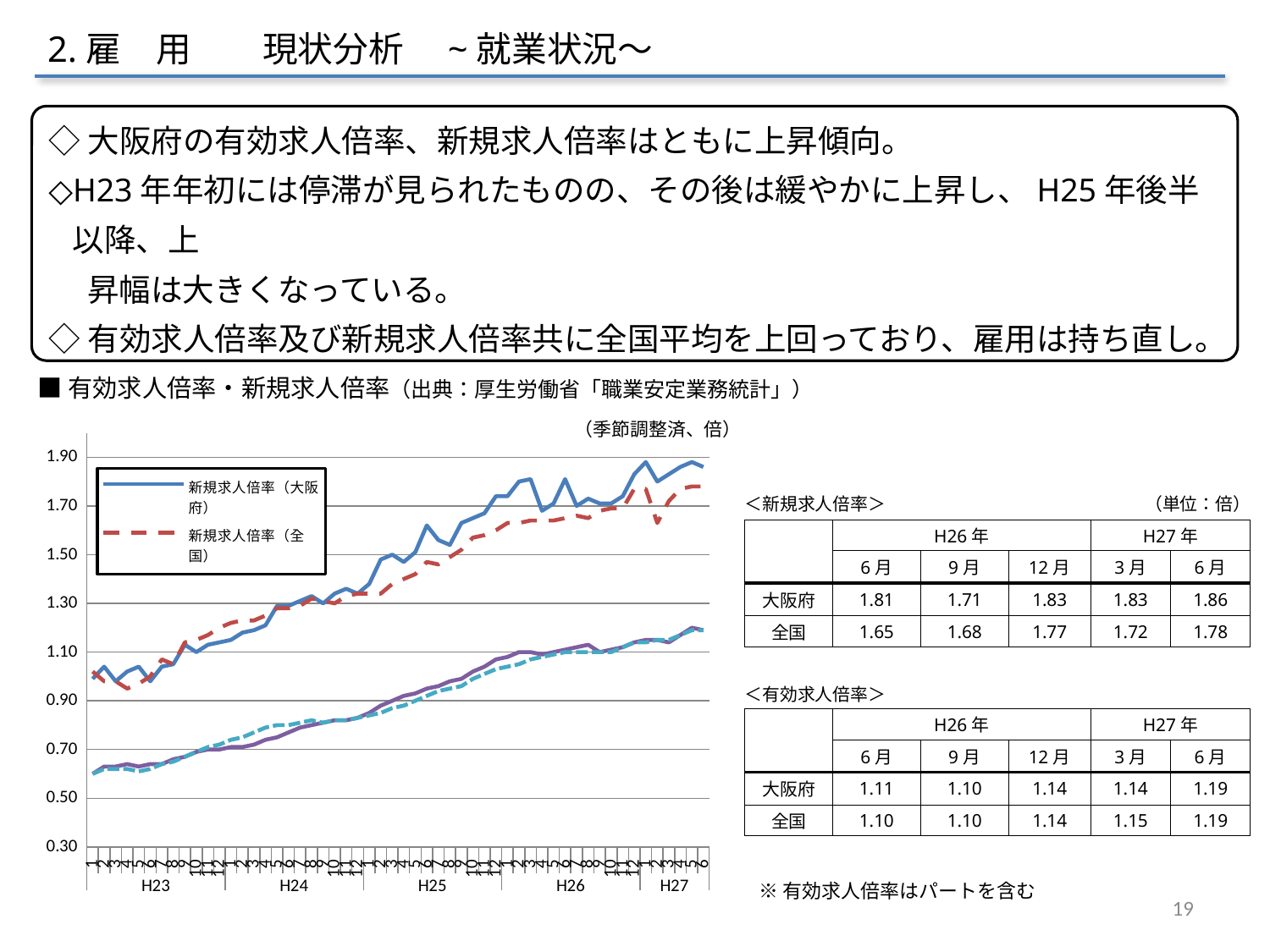
In the 新規求人倍率 table, which is larger in H26年9月, 大阪府 or 全国? 大阪府 Is the value of the 新規求人倍率（大阪府） line at the end of H27 greater or less than 1.70? greater According to the 有効求人倍率 table, what is the value for 大阪府 in H27年6月? 1.19 Is the value of the 新規求人倍率（全国） line at the start of H23 greater or less than 1.10? less What kind of chart is shown on the slide? line chart In the 新規求人倍率 table, what is the difference between 大阪府 and 全国 in H27年6月? 0.08 According to the 新規求人倍率 table, what is the value for 大阪府 in H27年6月? 1.86 According to the 新規求人倍率 table, what is the value for 全国 in H26年6月? 1.65 How many fiscal-year labels (H23 to H27) appear along the x axis of the chart? 5 How many series does the chart's legend list? 2 In the 新規求人倍率 table, which month shows the highest value for 大阪府? H27年6月 Does the 新規求人倍率（大阪府） line rise or fall overall from H23 to H27? rise